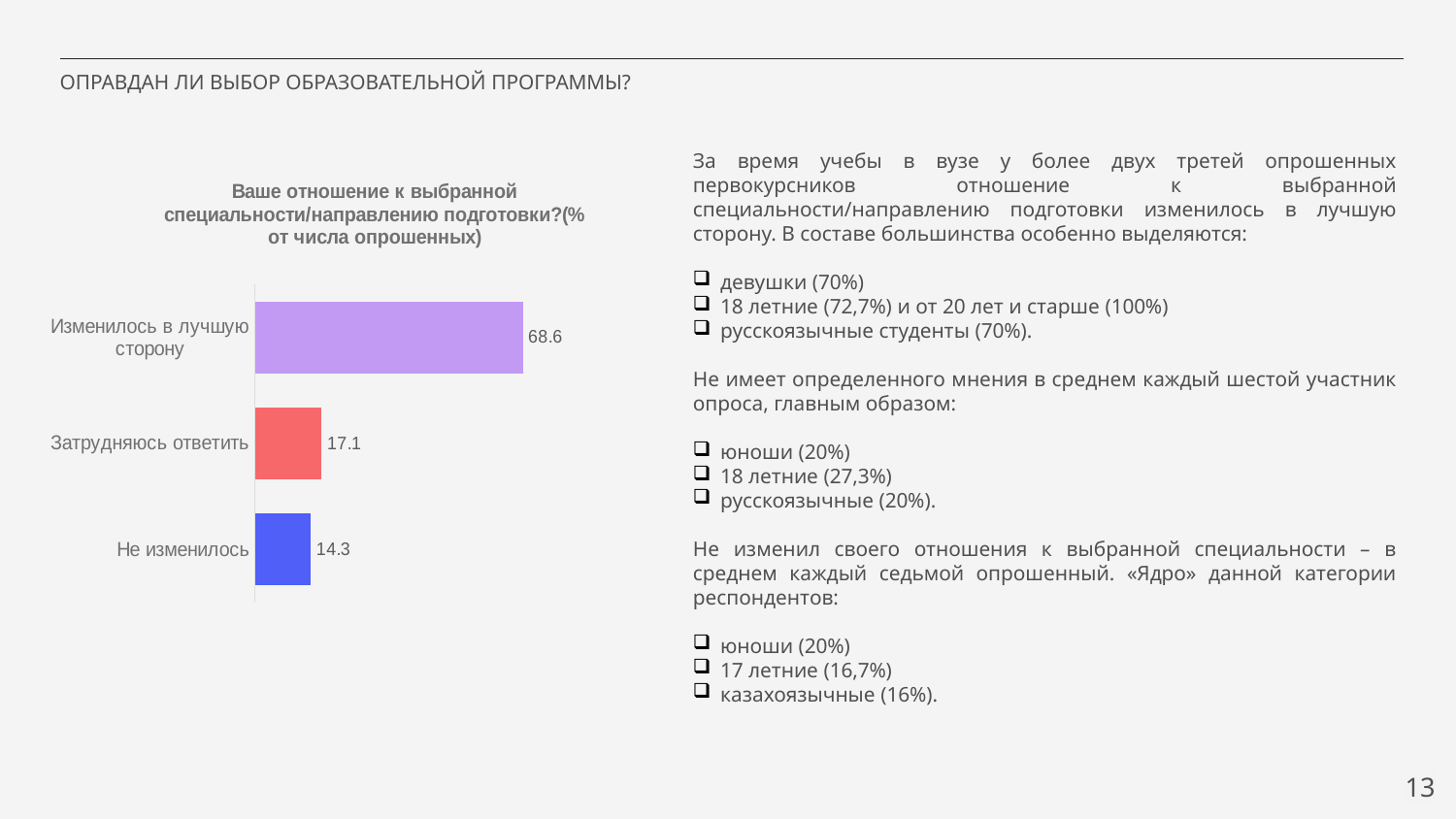
What colour is the bar for "Не изменилось"? Blue What is the difference between the values for "Затрудняюсь ответить" and "Не изменилось"? 2.8 How many categories are shown in the chart? 3 What is the difference between the values for "Изменилось в лучшую сторону" and "Затрудняюсь ответить"? 51.5 What is the value for "Изменилось в лучшую сторону"? 68.6 What is the value for "Затрудняюсь ответить"? 17.1 What kind of chart is shown on the slide? Bar chart What is the title of the chart? Ваше отношение к выбранной специальности/направлению подготовки?(% от числа опрошенных) Which is larger, the value for "Затрудняюсь ответить" or the value for "Не изменилось"? Затрудняюсь ответить Which category has the highest value? Изменилось в лучшую сторону What is the value for "Не изменилось"? 14.3 Which category has the lowest value? Не изменилось